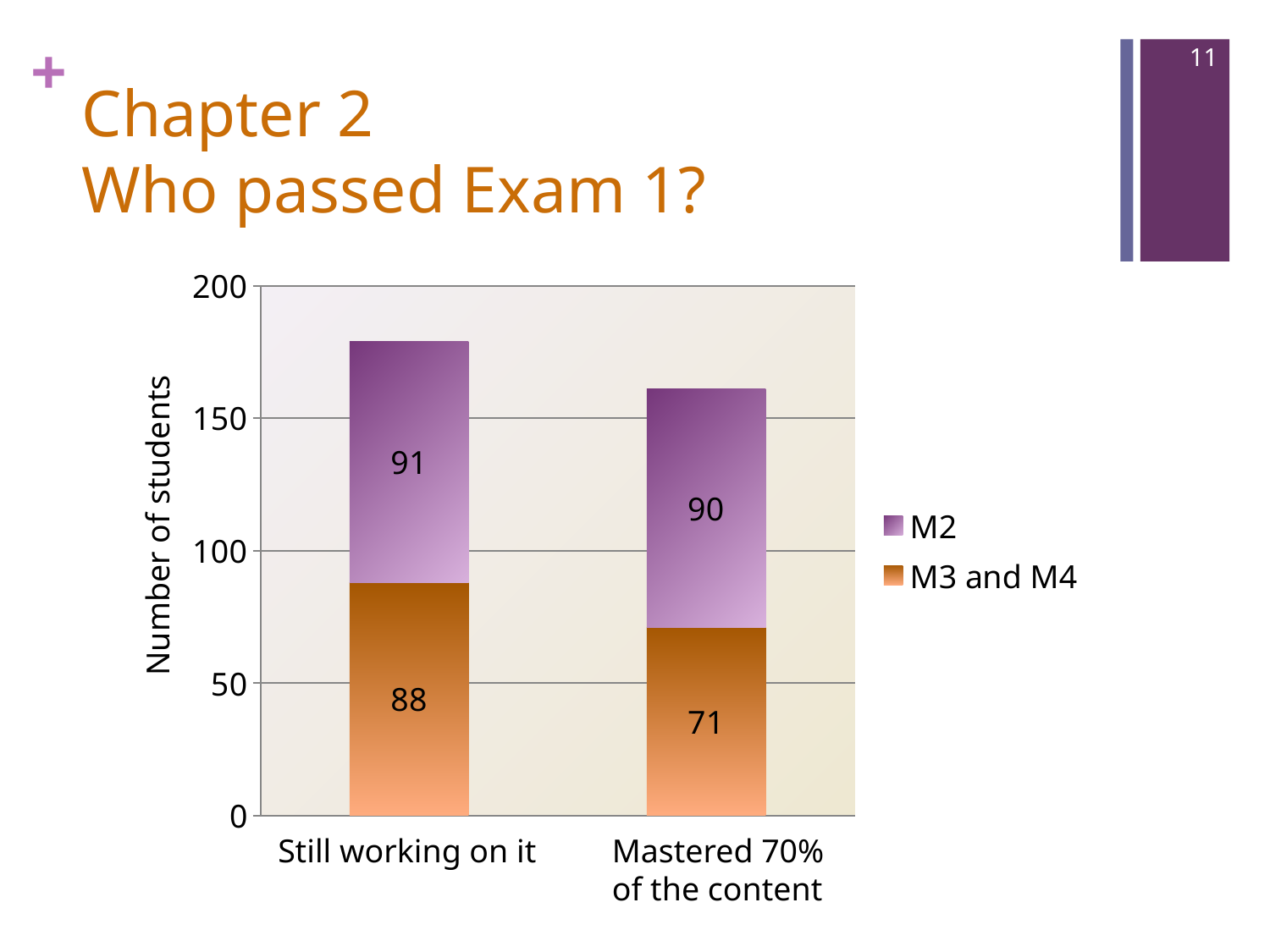
What is the M3 and M4 value for "Mastered 70% of the content"? 71 What is the difference between the M3 and M4 values for "Still working on it" and "Mastered 70% of the content"? 17 What is the total number of students in the "Still working on it" bar? 179 Is the total for "Mastered 70% of the content" greater or less than 150? greater What is the M2 value for "Mastered 70% of the content"? 90 What is the M2 value for "Still working on it"? 91 What is the label of the vertical axis? Number of students What is the total number of students in the "Mastered 70% of the content" bar? 161 Which category has the higher M3 and M4 value? Still working on it How many series does the legend list? 2 What is the M3 and M4 value for "Still working on it"? 88 What kind of chart is shown? Stacked bar chart